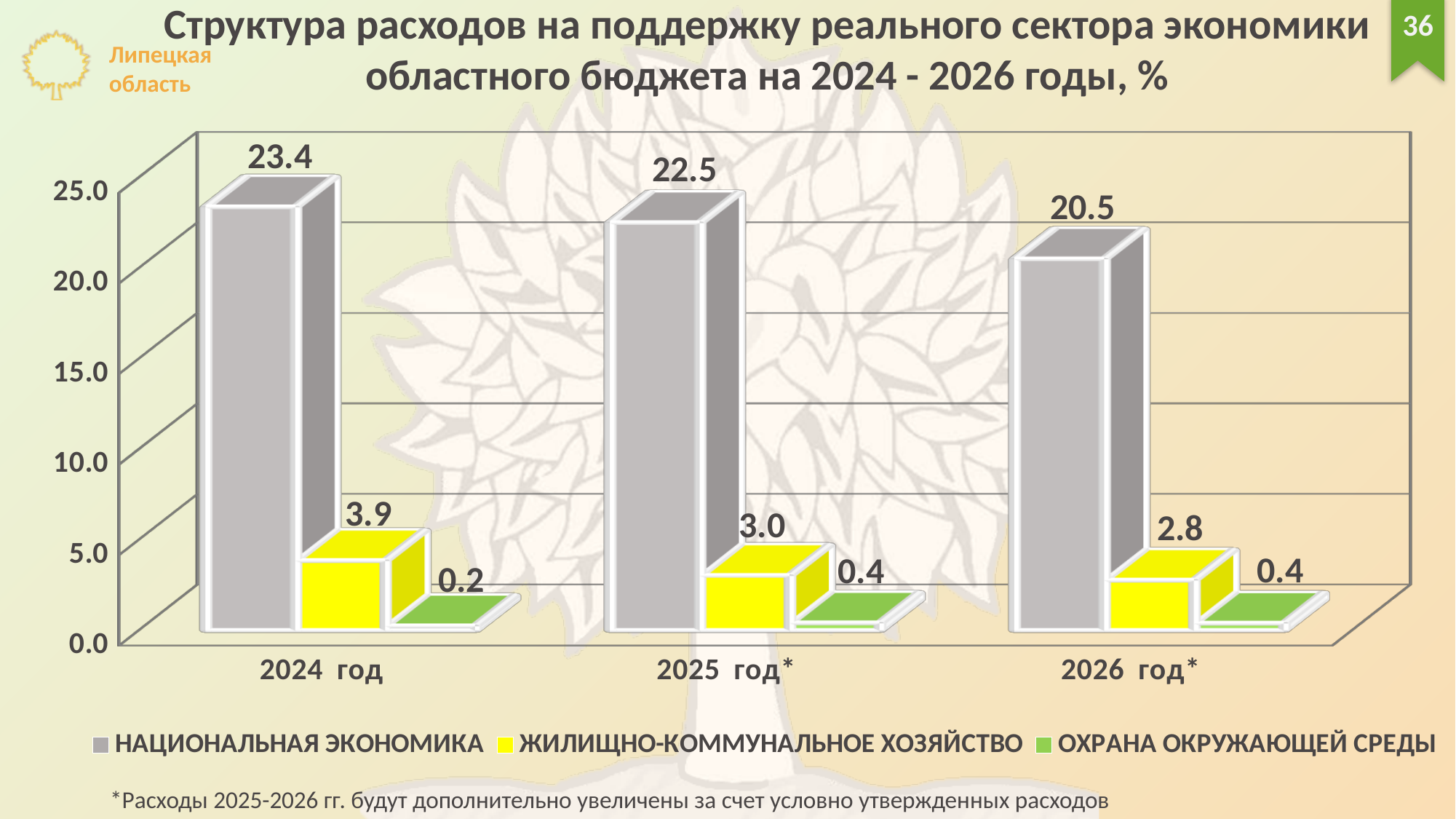
How many years are shown on the x axis? 3 How many series does the legend list? 3 Does the value for НАЦИОНАЛЬНАЯ ЭКОНОМИКА rise or fall from 2024 to 2026? fall What is the value for НАЦИОНАЛЬНАЯ ЭКОНОМИКА in 2024 год? 23.4 Is the value for НАЦИОНАЛЬНАЯ ЭКОНОМИКА in 2025 год* greater or less than 20.0? greater In which year is the value for ЖИЛИЩНО-КОММУНАЛЬНОЕ ХОЗЯЙСТВО the lowest? 2026 год* What is the value for ОХРАНА ОКРУЖАЮЩЕЙ СРЕДЫ in 2026 год*? 0.4 Which is larger: ЖИЛИЩНО-КОММУНАЛЬНОЕ ХОЗЯЙСТВО in 2024 год or in 2025 год*? 2024 год What is the value for ЖИЛИЩНО-КОММУНАЛЬНОЕ ХОЗЯЙСТВО in 2025 год*? 3.0 What kind of chart is shown on the slide? bar chart In which year is the value for НАЦИОНАЛЬНАЯ ЭКОНОМИКА the highest? 2024 год What is the difference between the НАЦИОНАЛЬНАЯ ЭКОНОМИКА values for 2024 год and 2026 год*? 2.9